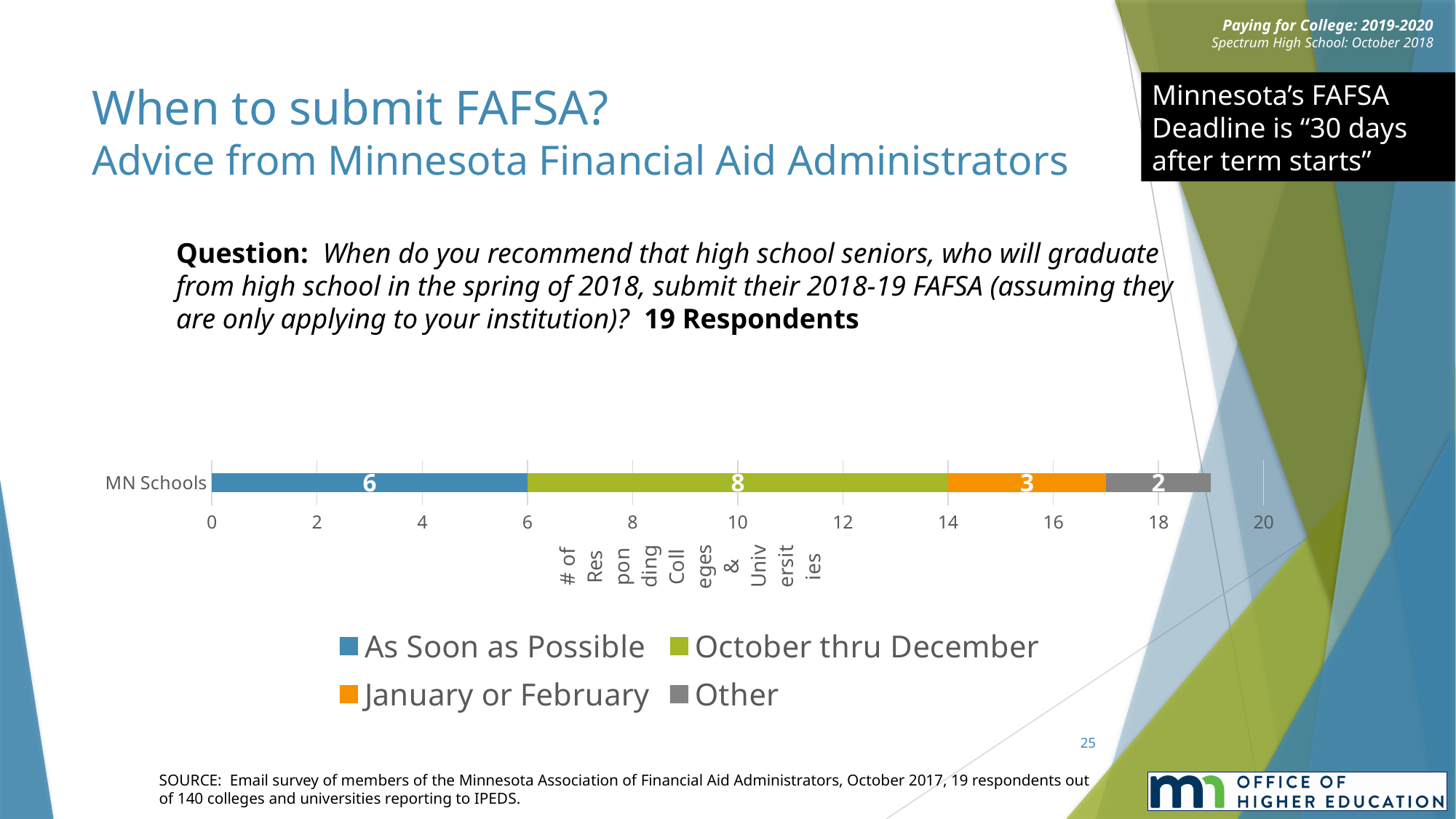
What is the value for "October thru December" in the MN Schools bar? 8 What is the value for "January or February" in the MN Schools bar? 3 What is the total of the stacked MN Schools bar? 19 What kind of chart is shown on the slide? Stacked bar chart What is the value for "Other" in the MN Schools bar? 2 How many series does the legend list? 4 Which series has the highest value in the MN Schools bar? October thru December What is the value for "As Soon as Possible" in the MN Schools bar? 6 What is the difference between the "October thru December" value and the "As Soon as Possible" value? 2 What colour represents "January or February" in the chart? Orange Which series has the lowest value in the MN Schools bar? Other Which is larger, the value for "January or February" or the value for "Other"? January or February